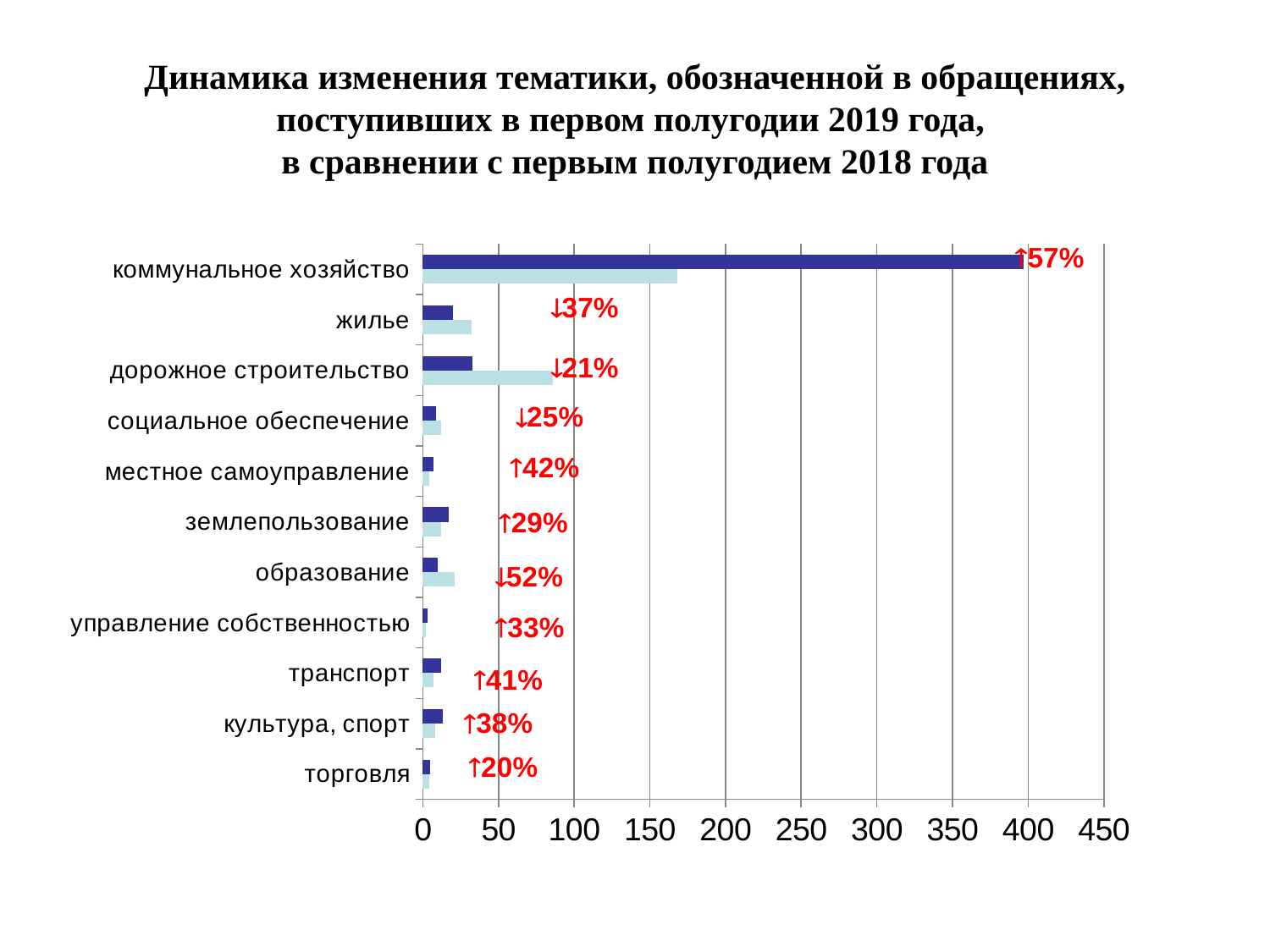
Is the dark blue bar for коммунальное хозяйство greater or less than 350? greater How many categories have a percentage label with a downward arrow? 4 Which has the longer dark blue bar: жилье or дорожное строительство? дорожное строительство What kind of chart is shown on the slide? bar chart For жилье, which bar is longer: the dark blue bar or the light blue bar? light blue Is the light blue bar for коммунальное хозяйство greater or less than 200? less What percentage change is printed next to образование? ↓52% How many categories are listed on the vertical axis of the chart? 11 Which category has the longest bar in the chart? коммунальное хозяйство What percentage change is printed next to торговля? ↑20% What percentage change is printed next to коммунальное хозяйство? ↑57% Is the light blue bar for дорожное строительство greater or less than 50? greater